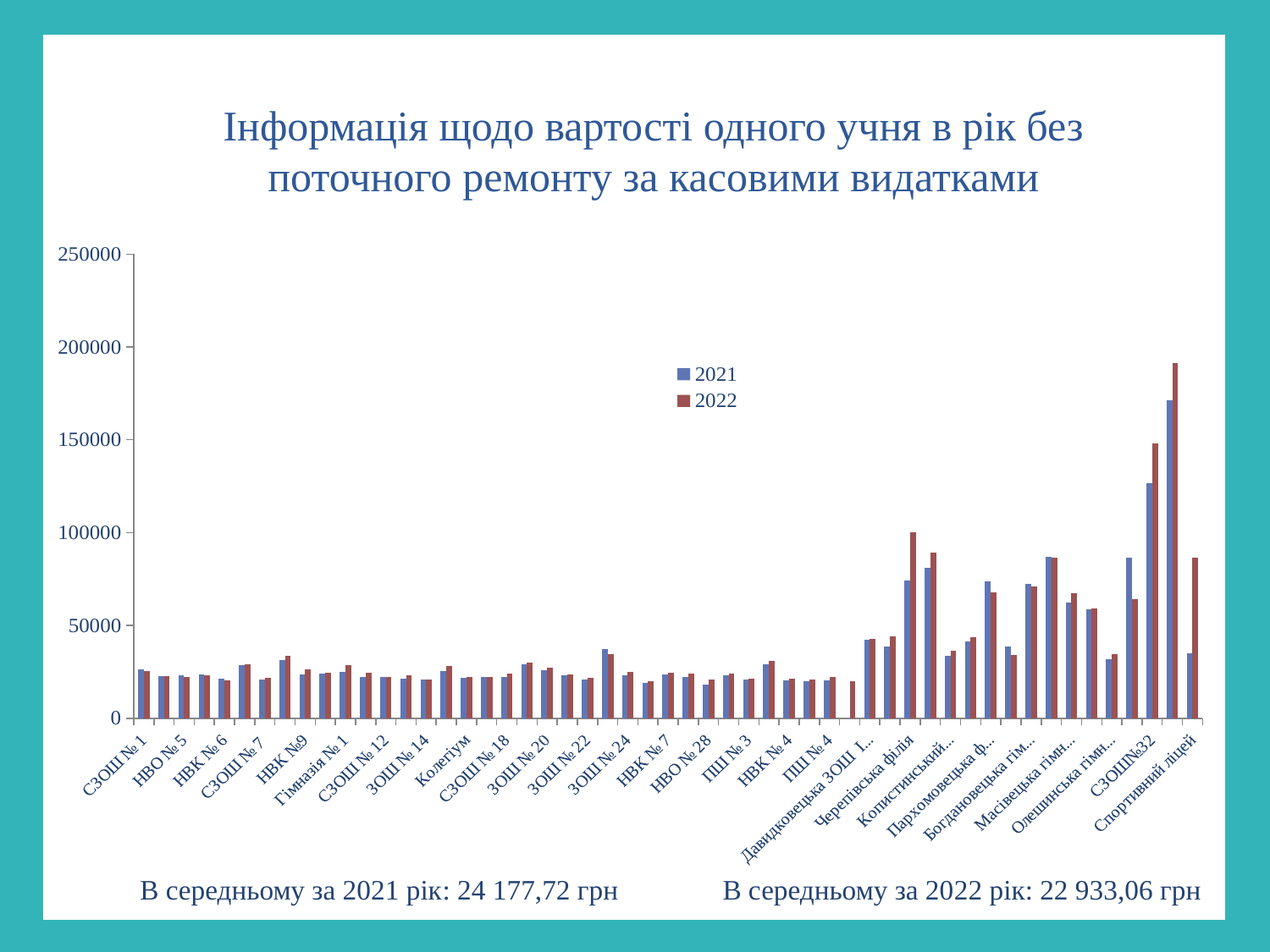
What is the title of the chart? Інформація щодо вартості одного учня в рік без поточного ремонту за касовими видатками What are the two series named in the legend? 2021 and 2022 Is the 2021 value for Колегіум greater or less than 50000? less Is the 2021 value for СЗОШ № 1 greater or less than 50000? less Which series contains the tallest bar on the chart? 2022 Is the 2022 value for Давидковецька ЗОШ greater or less than 50000? less What kind of chart is shown on the slide? bar chart How many series does the legend list? 2 Do the values generally rise or fall moving from the left of the x axis to the right? rise